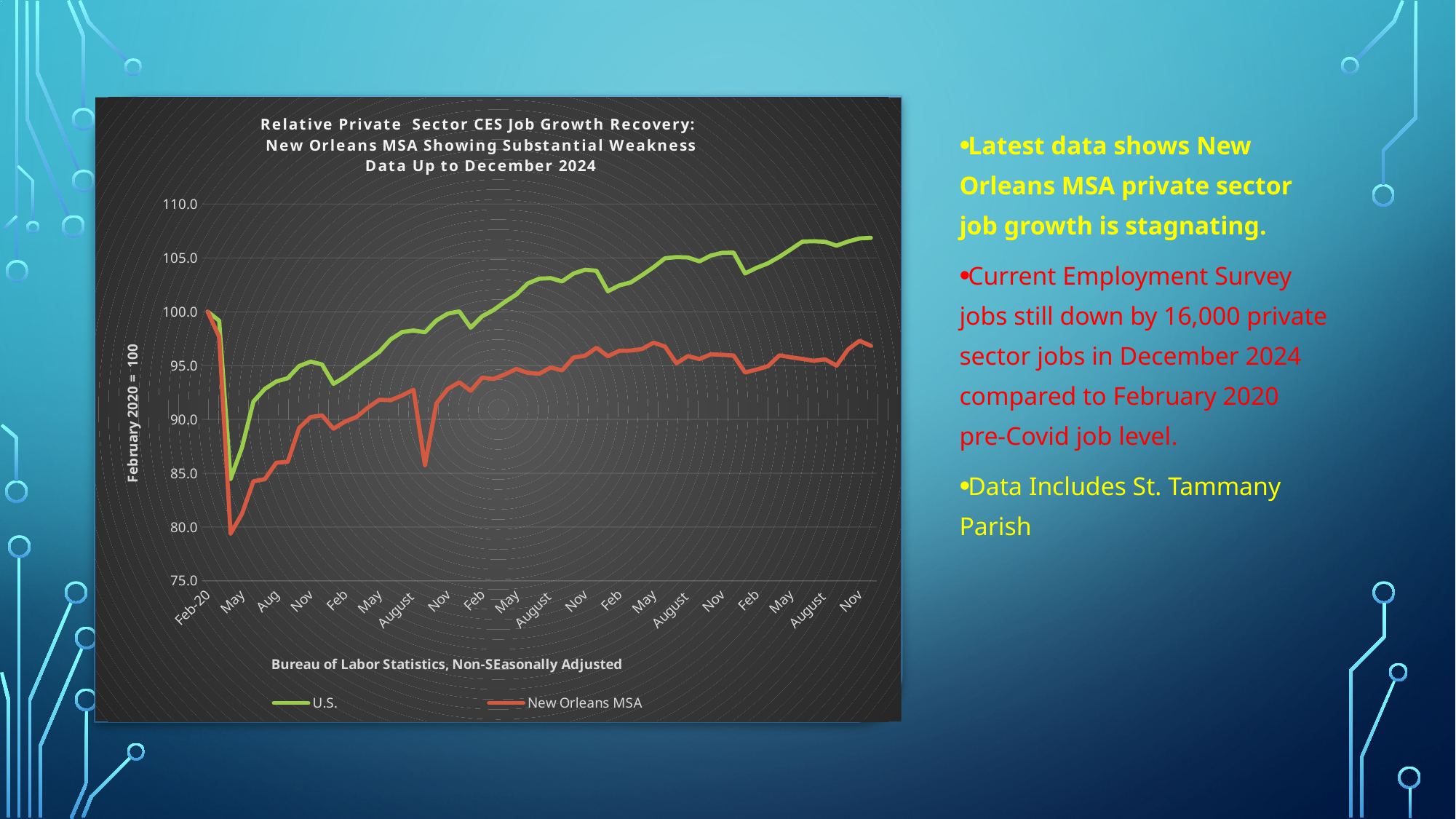
How many series does the legend list? 2 Which series drops lower in the spring of 2020, U.S. or New Orleans MSA? New Orleans MSA What kind of chart is shown on the slide? line chart Is the final value for the U.S. series greater or less than 105.0? greater Is the lowest point of the U.S. series greater or less than 80.0? greater What is the value of both series at Feb-20, the first point on the x axis? 100.0 Is the lowest point of the New Orleans MSA series greater or less than 80.0? less Which series is higher at the end of the chart (Nov/Dec 2024), U.S. or New Orleans MSA? U.S. What are the two series named in the legend? U.S. and New Orleans MSA Overall, does the U.S. series rise or fall from Feb-20 to the end of the chart? rise What is the title of the y axis? February 2020 = 100